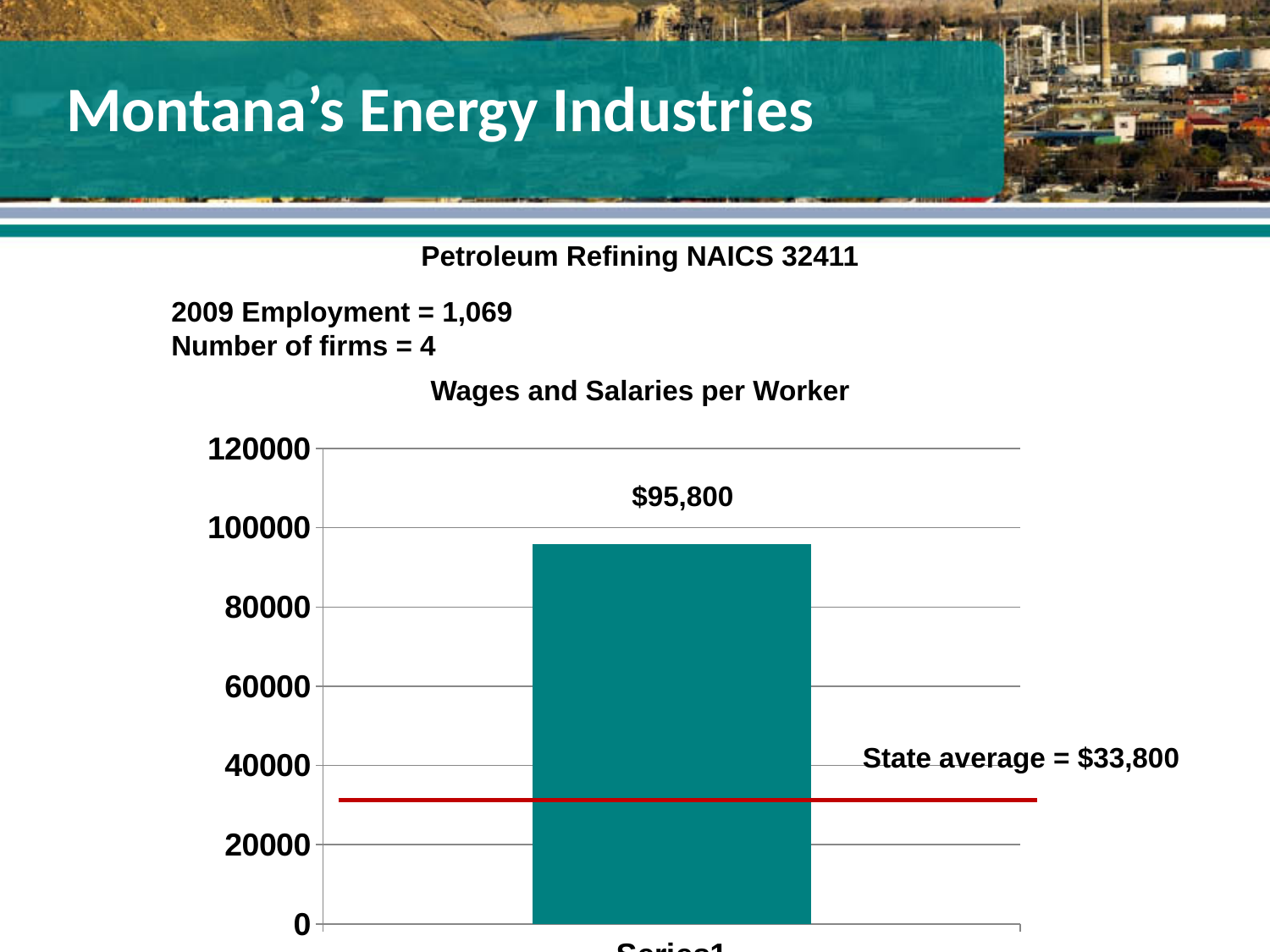
What is the value shown on the bar in the Wages and Salaries per Worker chart? $95,800 By how much does the petroleum refining wage per worker ($95,800) exceed the state average ($33,800) in the chart? $62,000 What is the title of the chart on the slide? Wages and Salaries per Worker Which is larger in the Wages and Salaries per Worker chart: the bar value or the state average line? The bar value What is the highest value shown on the vertical axis of the Wages and Salaries per Worker chart? 120000 What is the state average shown on the Wages and Salaries per Worker chart? $33,800 Is the state average line in the Wages and Salaries per Worker chart greater or less than 40000? less What kind of chart is the Wages and Salaries per Worker chart? Bar chart Is the value of the bar in the Wages and Salaries per Worker chart greater or less than 80000? greater How many bars are plotted in the Wages and Salaries per Worker chart? 1